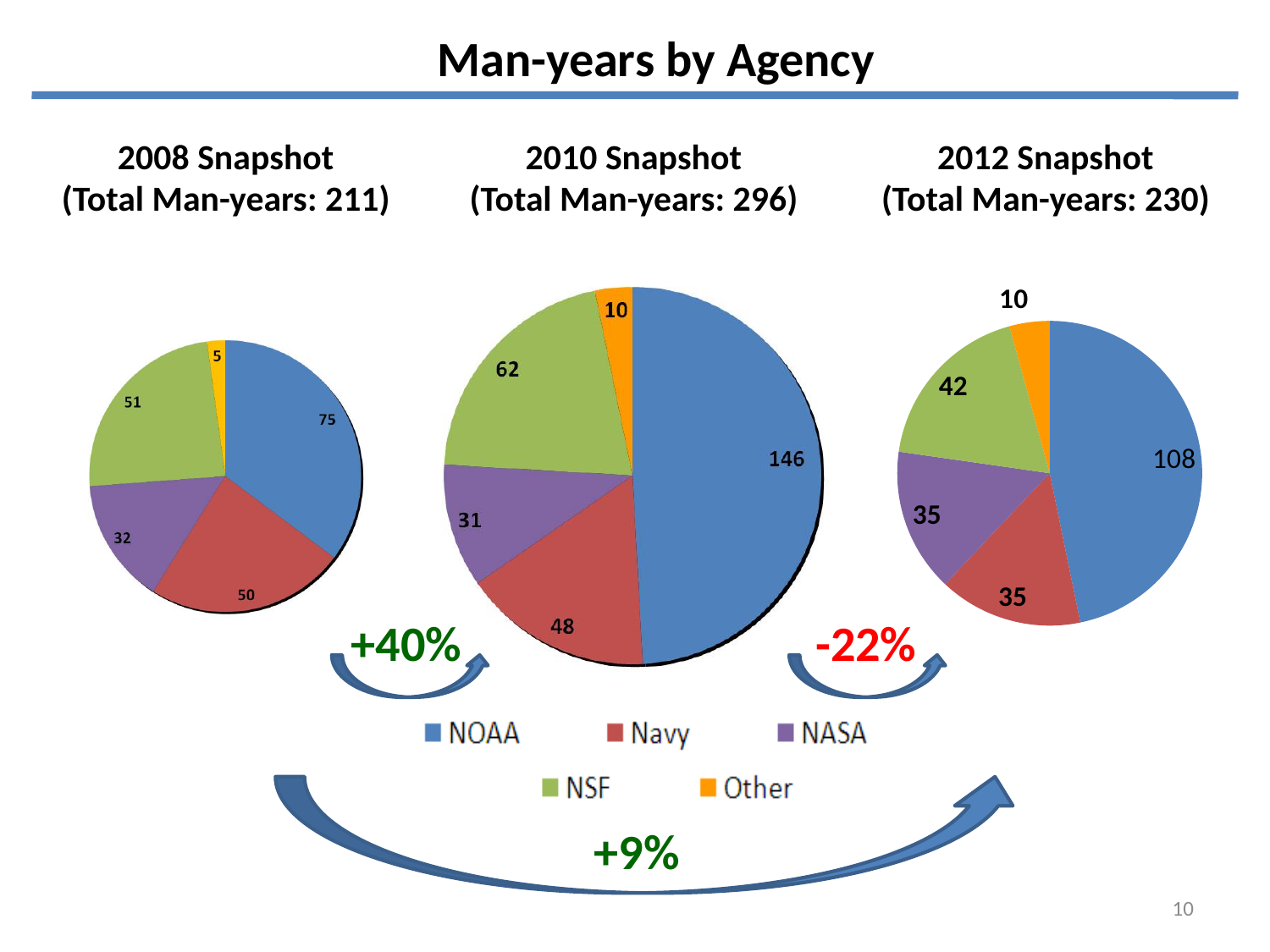
In the 2012 Snapshot pie chart, what is the difference between the NSF value and the Other value? 32 In the 2008 Snapshot pie chart, what is the value for NOAA? 75 In the 2010 Snapshot pie chart, which agency has the largest slice? NOAA In the 2008 Snapshot pie chart, which category has the smallest slice? Other Which colour represents NSF in the pie charts? Green In the 2010 Snapshot pie chart, which is larger, the Navy slice or the NASA slice? Navy In the 2010 Snapshot pie chart, what is the value for NSF? 62 What kind of charts are shown on the slide? Pie charts In the 2012 Snapshot pie chart, what is the value for NASA? 35 How many categories does the legend list? 5 What is the total man-years shown for the 2010 Snapshot? 296 What is the difference between the NOAA value in the 2010 Snapshot and the NOAA value in the 2008 Snapshot? 71